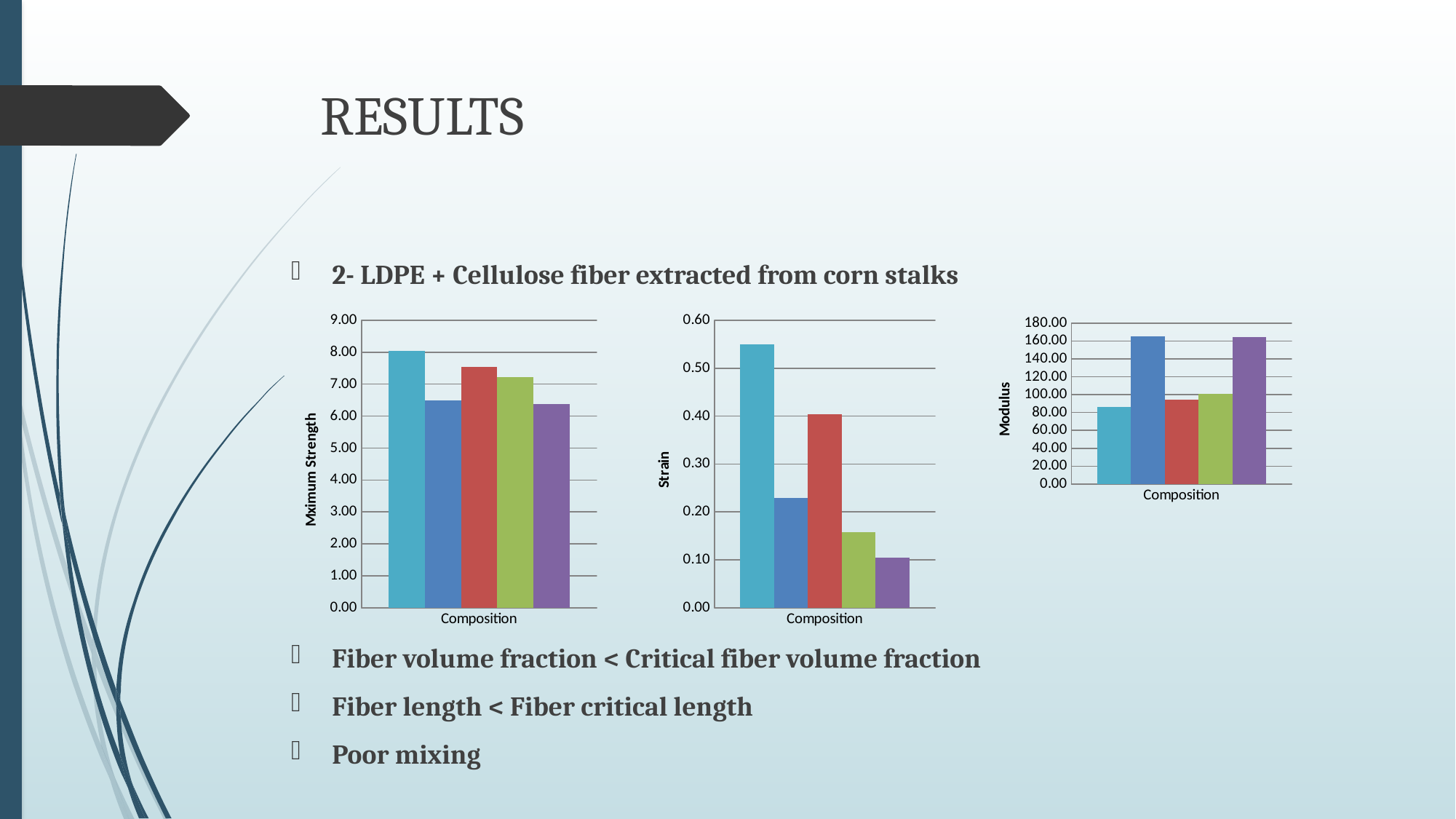
How many bars are plotted in the middle chart (Strain)? 5 What kind of chart is the left chart (Maximum Strength)? bar chart In the middle chart (Strain), which bar is the highest? the first (teal) bar In the middle chart (Strain), which is larger, the red bar or the blue bar? the red bar What is the y-axis label of the right chart? Modulus In the left chart (Maximum Strength), which bar is the highest? the first (teal) bar In the left chart (Maximum Strength), is the value of the second (blue) bar greater or less than 7.00? less In the right chart (Modulus), which is larger, the blue bar or the red bar? the blue bar In the middle chart (Strain), is the value of the first (teal) bar greater or less than 0.50? greater In the middle chart (Strain), which bar is the lowest? the last (purple) bar In the right chart (Modulus), is the value of the second (blue) bar greater or less than 140.00? greater